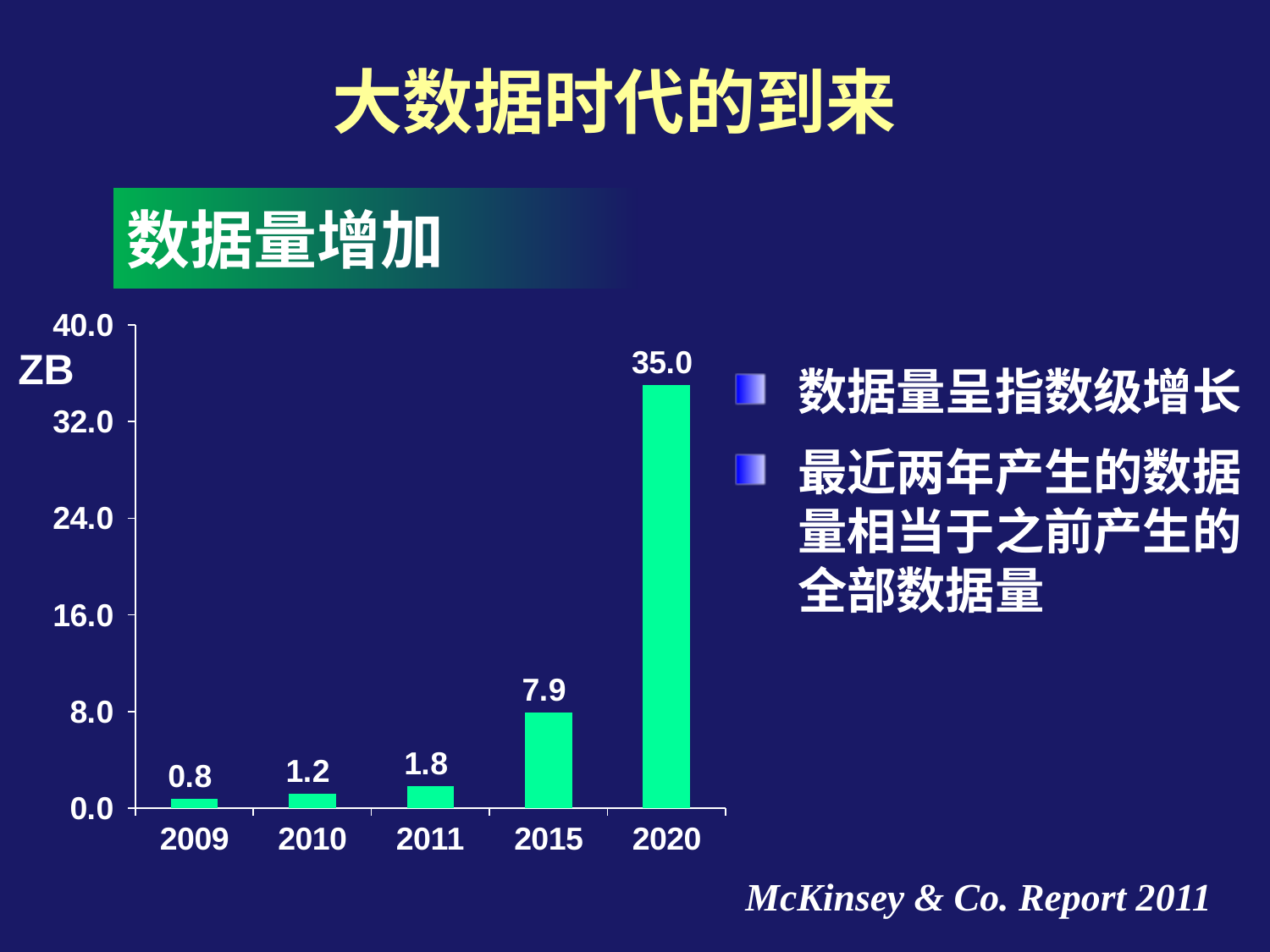
Which year has the highest value? 2020 What is the value for 2015? 7.9 Which year has the lowest value? 2009 What is the difference between the values for 2011 and 2010? 0.6 How many years are shown on the x axis? 5 Which is larger, the value for 2011 or the value for 2010? 2011 What kind of chart is shown on the slide? bar chart What is the value for 2020? 35.0 What is the difference between the values for 2020 and 2015? 27.1 Is the value for 2020 greater or less than 32.0? greater What is the value for 2009? 0.8 Do the values rise or fall from 2009 to 2020? rise